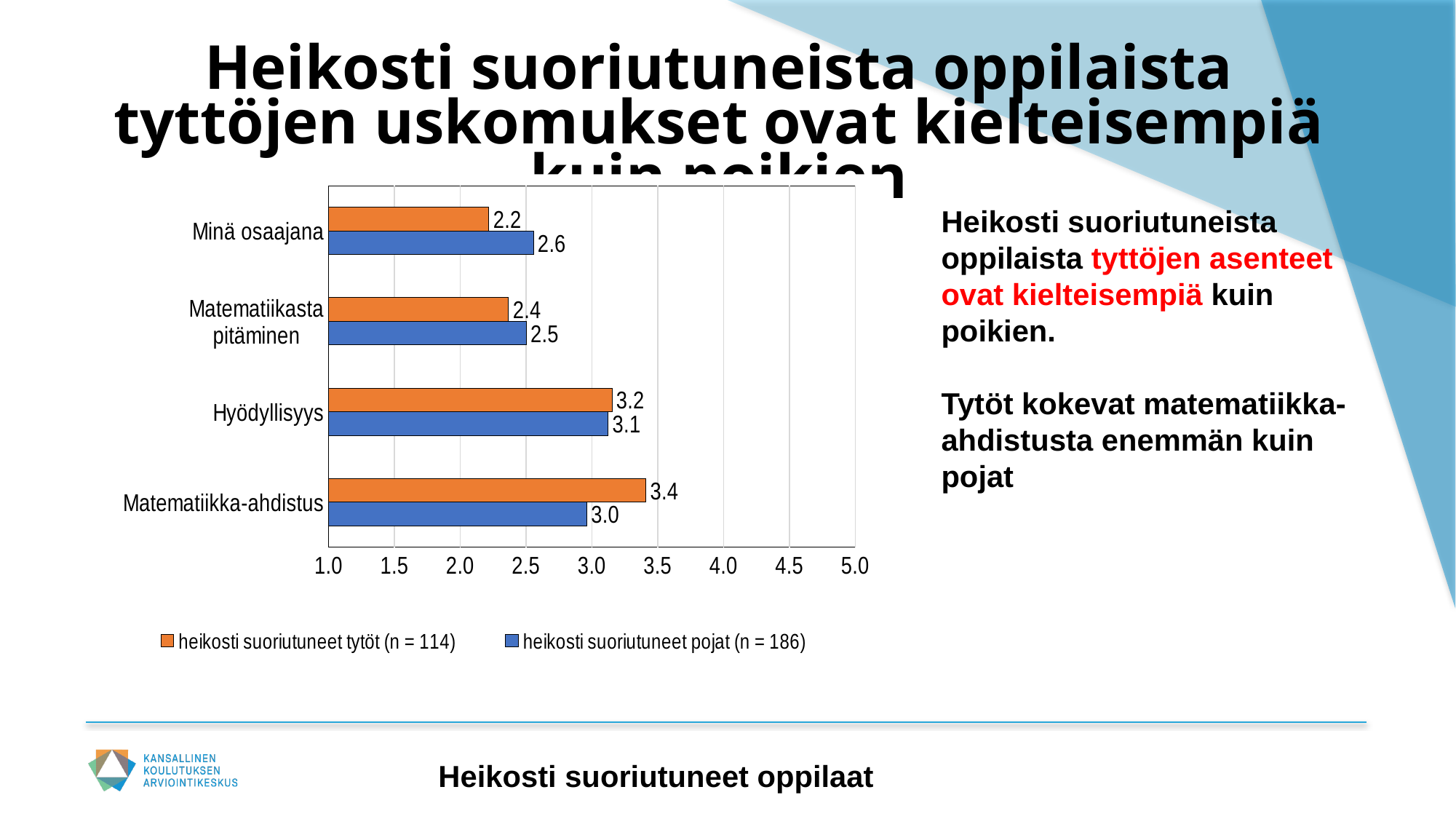
What is the difference between the tytöt and pojat values in the Matematiikka-ahdistus category? 0.4 How many series does the legend list? 2 What is the value for heikosti suoriutuneet pojat (n = 186) in the Hyödyllisyys category? 3.1 Is the value for heikosti suoriutuneet tytöt in the Hyödyllisyys category greater or less than 3.0? greater What colour represents heikosti suoriutuneet tytöt (n = 114) in the chart? orange Which category has the lowest value for heikosti suoriutuneet pojat (n = 186)? Matematiikasta pitäminen What is the value for heikosti suoriutuneet tytöt (n = 114) in the Minä osaajana category? 2.2 Which category has the highest value for heikosti suoriutuneet tytöt (n = 114)? Matematiikka-ahdistus How many categories are shown on the chart? 4 What kind of chart is shown on the slide? bar chart What is the value for heikosti suoriutuneet pojat (n = 186) in the Matematiikka-ahdistus category? 3.0 In the Minä osaajana category, which series has the larger value, heikosti suoriutuneet tytöt or heikosti suoriutuneet pojat? heikosti suoriutuneet pojat (n = 186)